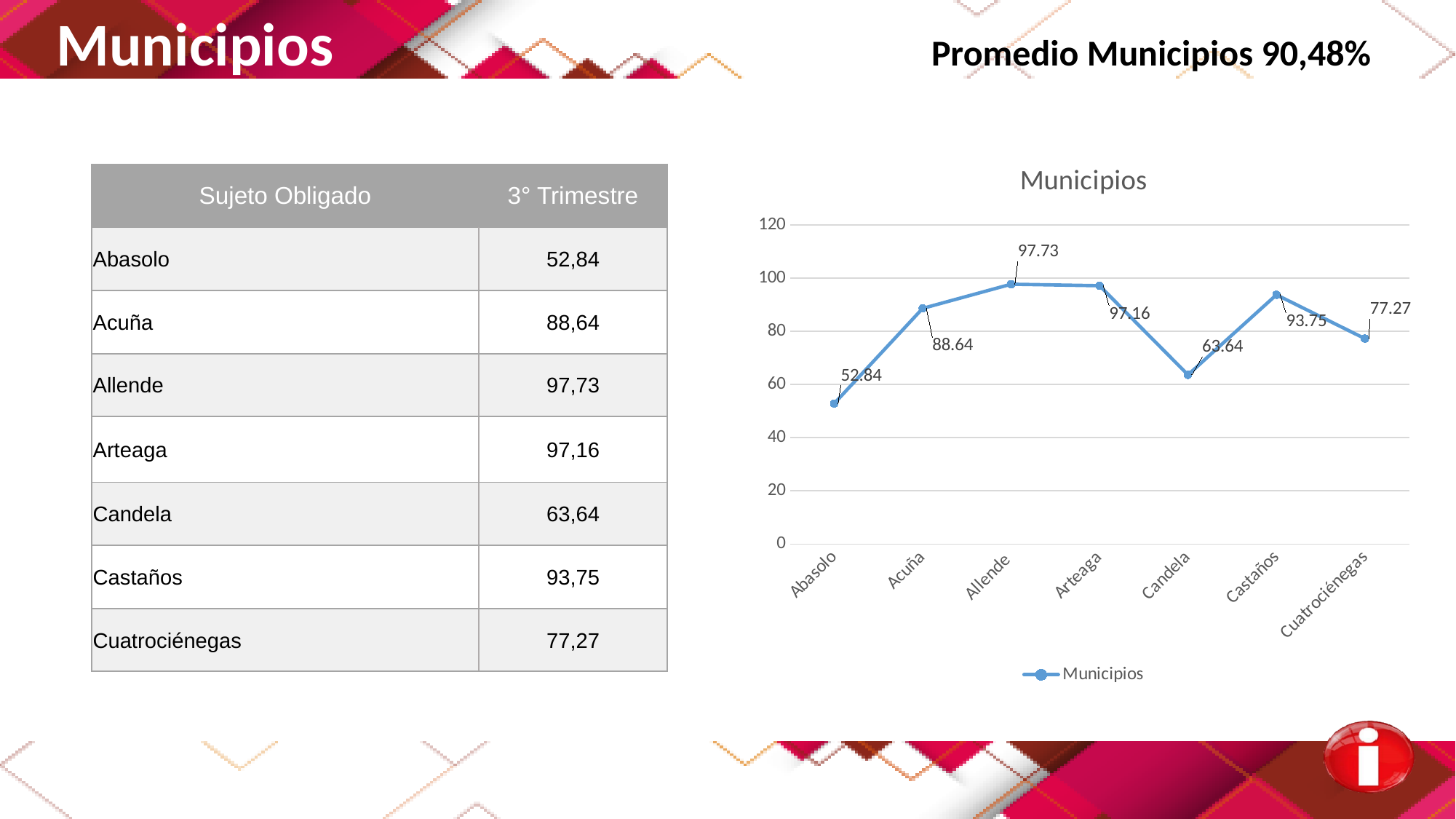
Which has a larger value in the Municipios chart, Castaños or Cuatrociénegas? Castaños Which municipality has the highest value in the Municipios chart? Allende How many municipalities are plotted in the Municipios chart? 7 What is the difference between the values for Acuña and Abasolo in the Municipios chart? 35.80 Which municipality has the lowest value in the Municipios chart? Abasolo What is the value for Candela in the Municipios chart? 63.64 What type of chart is shown on the slide? Line chart Is the value for Candela in the Municipios chart greater or less than 80? less What is the value for Abasolo in the Municipios chart? 52.84 How many series does the legend of the Municipios chart list? 1 What is the title of the chart on the slide? Municipios What is the value for Castaños in the Municipios chart? 93.75